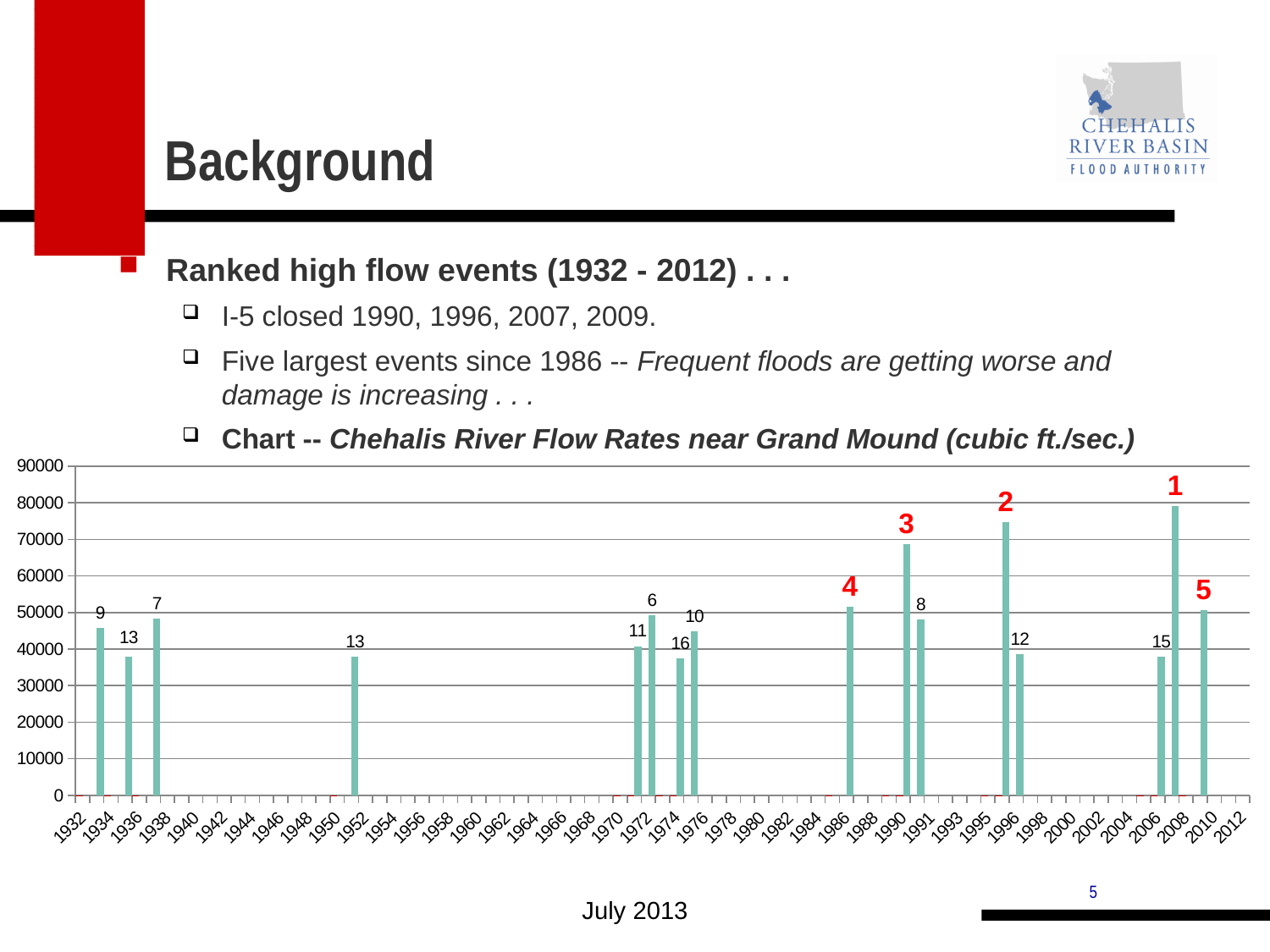
Is the flow rate for 1990 greater or less than 60000? greater Is the flow rate for 2009 greater or less than 40000? greater Which year has the highest flow rate in the chart? 2007 Is the flow rate for 2007 greater or less than 70000? greater How many bars with rank labels are plotted in the chart? 16 What kind of chart is shown on the slide? bar chart Which has the larger flow rate, 2007 or 1996? 2007 What rank label is printed above the bar for 1990? 3